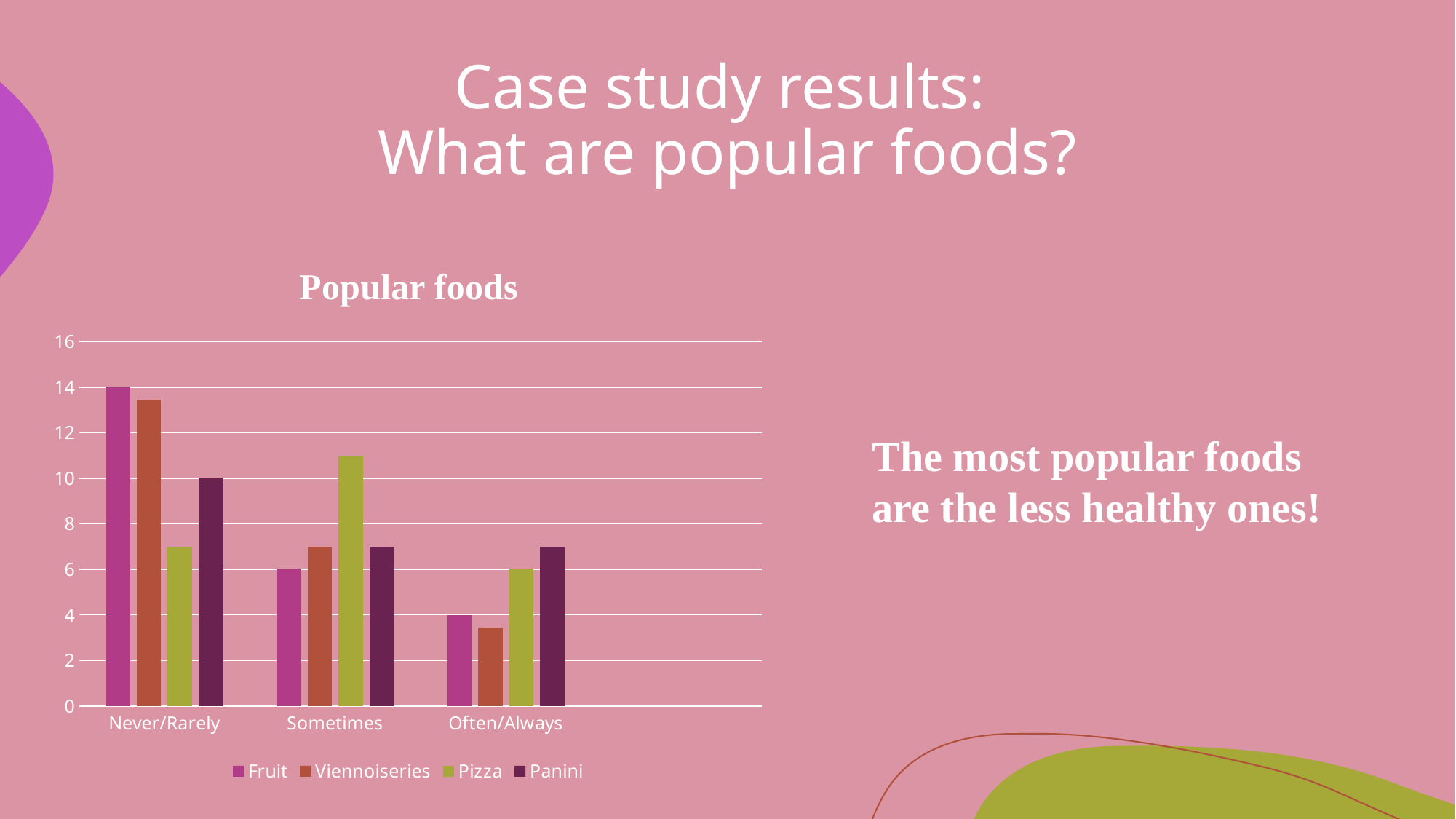
What kind of chart is shown on the slide? bar chart What is the value for Panini in the Never/Rarely category? 10 Which series has the lowest value in the Never/Rarely category? Pizza What is the title of the chart? Popular foods Is the value for Pizza in the Sometimes category greater or less than 10? greater How many series does the chart's legend list? 4 What is the value for Fruit in the Often/Always category? 4 Do the values for Fruit rise or fall from Never/Rarely to Often/Always? fall Which series has the highest value in the Sometimes category? Pizza How many categories are shown on the x axis of the chart? 3 Is the value for Viennoiseries in the Often/Always category greater or less than 4? less What is the value for Fruit in the Never/Rarely category? 14